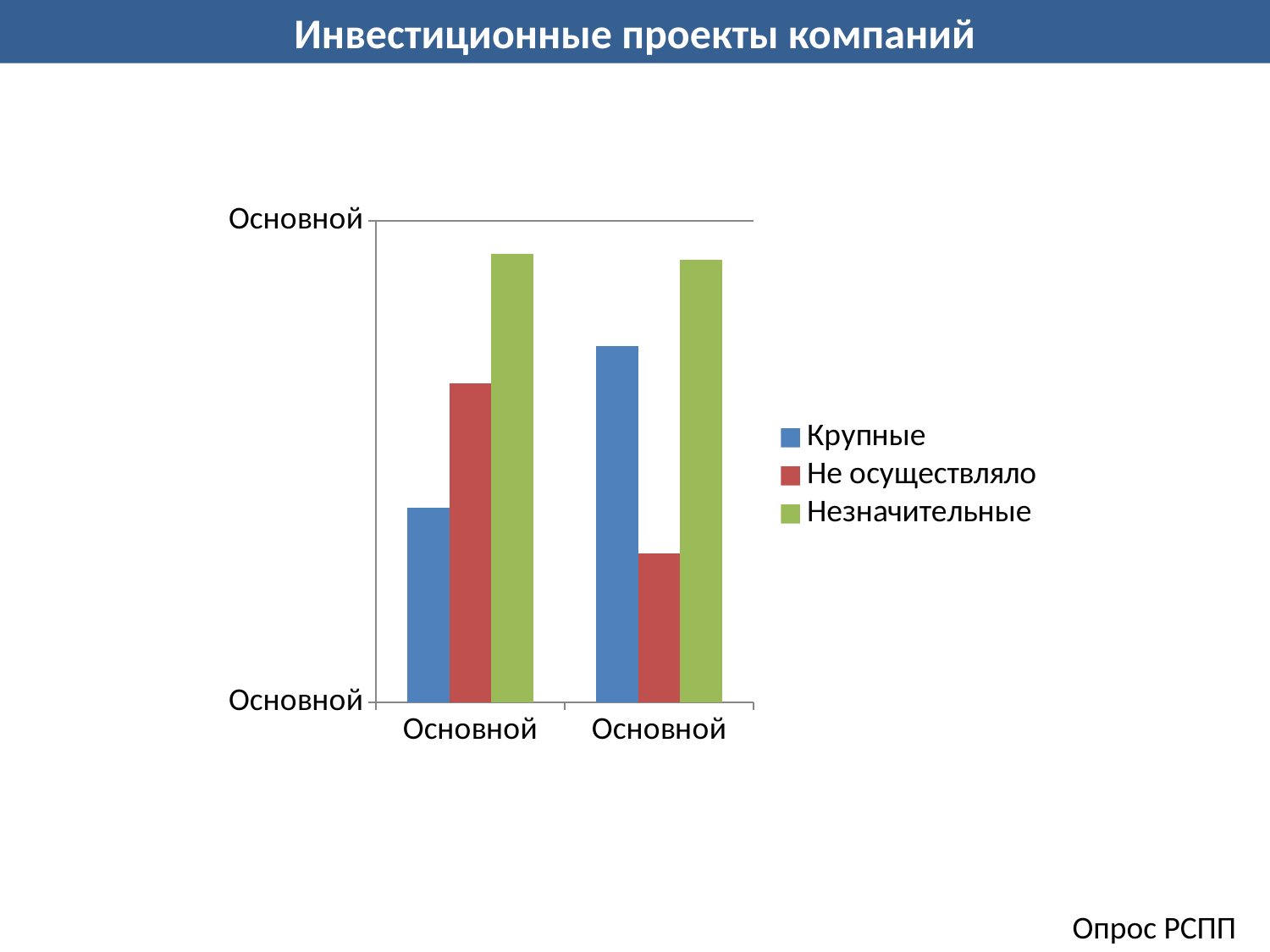
For the series Крупные, is the bar in the left group or the right group taller? right group For the series Не осуществляло, is the bar in the left group or the right group taller? left group In the left group of bars, which series has the lowest bar? Крупные How many groups of bars are plotted along the x axis? 2 In the right group of bars, which series has the highest bar? Незначительные In the left group, which is taller: the Крупные bar or the Не осуществляло bar? Не осуществляло In the left group of bars, which series has the highest bar? Незначительные Which legend entry is shown in green? Незначительные What is the title of the slide containing the chart? Инвестиционные проекты компаний In the right group of bars, which series has the lowest bar? Не осуществляло What kind of chart is shown on the slide? bar chart How many series does the legend list? 3